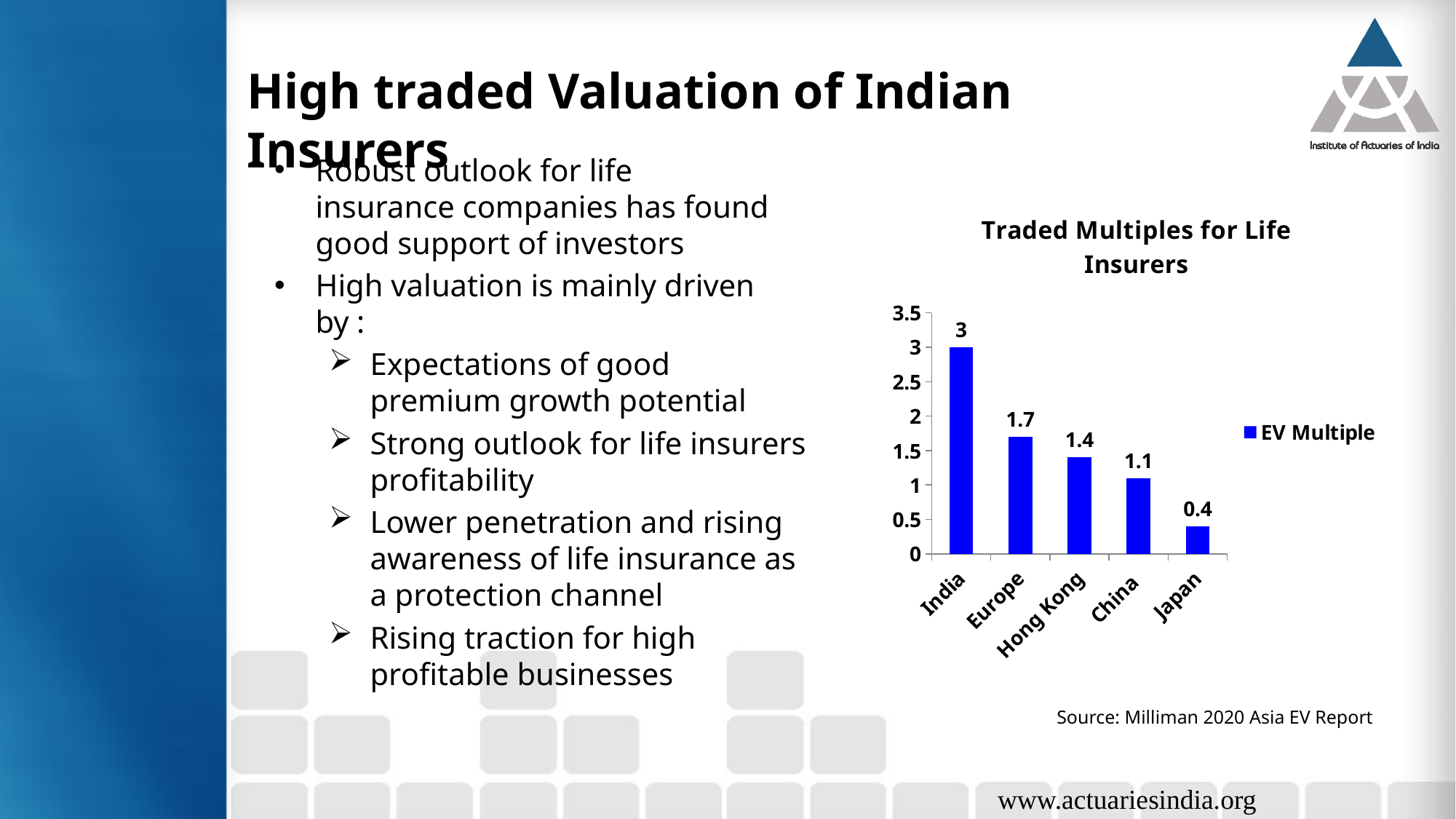
Which country has the highest EV Multiple? India What is the difference between the EV Multiple for India and Europe? 1.3 Is the EV Multiple for Hong Kong greater or less than 1.5? less What is the difference between the EV Multiple for China and Japan? 0.7 What is the EV Multiple for Japan? 0.4 Which has a larger EV Multiple, Europe or China? Europe How many countries or regions are shown in the chart? 5 What is the EV Multiple for India? 3 What type of chart is shown on the slide? bar chart Which country has the lowest EV Multiple? Japan What is the EV Multiple for Hong Kong? 1.4 What is the title of the chart? Traded Multiples for Life Insurers